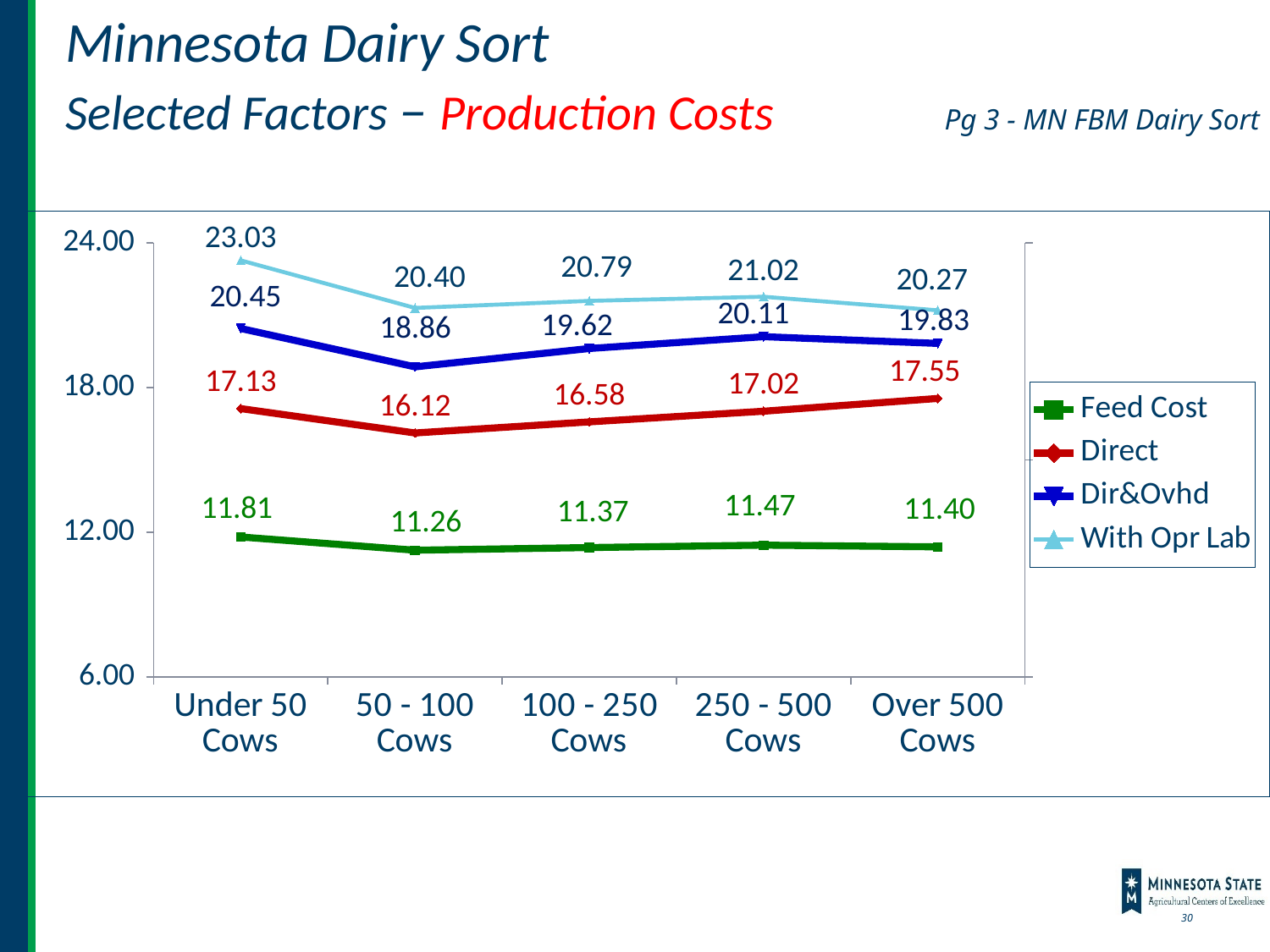
Which herd size category has the lowest Direct value? 50 - 100 Cows What is the Feed Cost value for Under 50 Cows? 11.81 Which herd size category has the highest With Opr Lab value? Under 50 Cows Which is larger, the Feed Cost value for 250 - 500 Cows or for Over 500 Cows? 250 - 500 Cows What is the Direct value for Over 500 Cows? 17.55 What kind of chart is shown on the slide? Line chart How many herd size categories are shown on the x axis? 5 How many series does the legend list? 4 Which series is shown in green in the legend? Feed Cost What is the Dir&Ovhd value for 100 - 250 Cows? 19.62 What is the difference between the With Opr Lab value and the Dir&Ovhd value for Under 50 Cows? 2.58 What is the With Opr Lab value for 50 - 100 Cows? 20.40